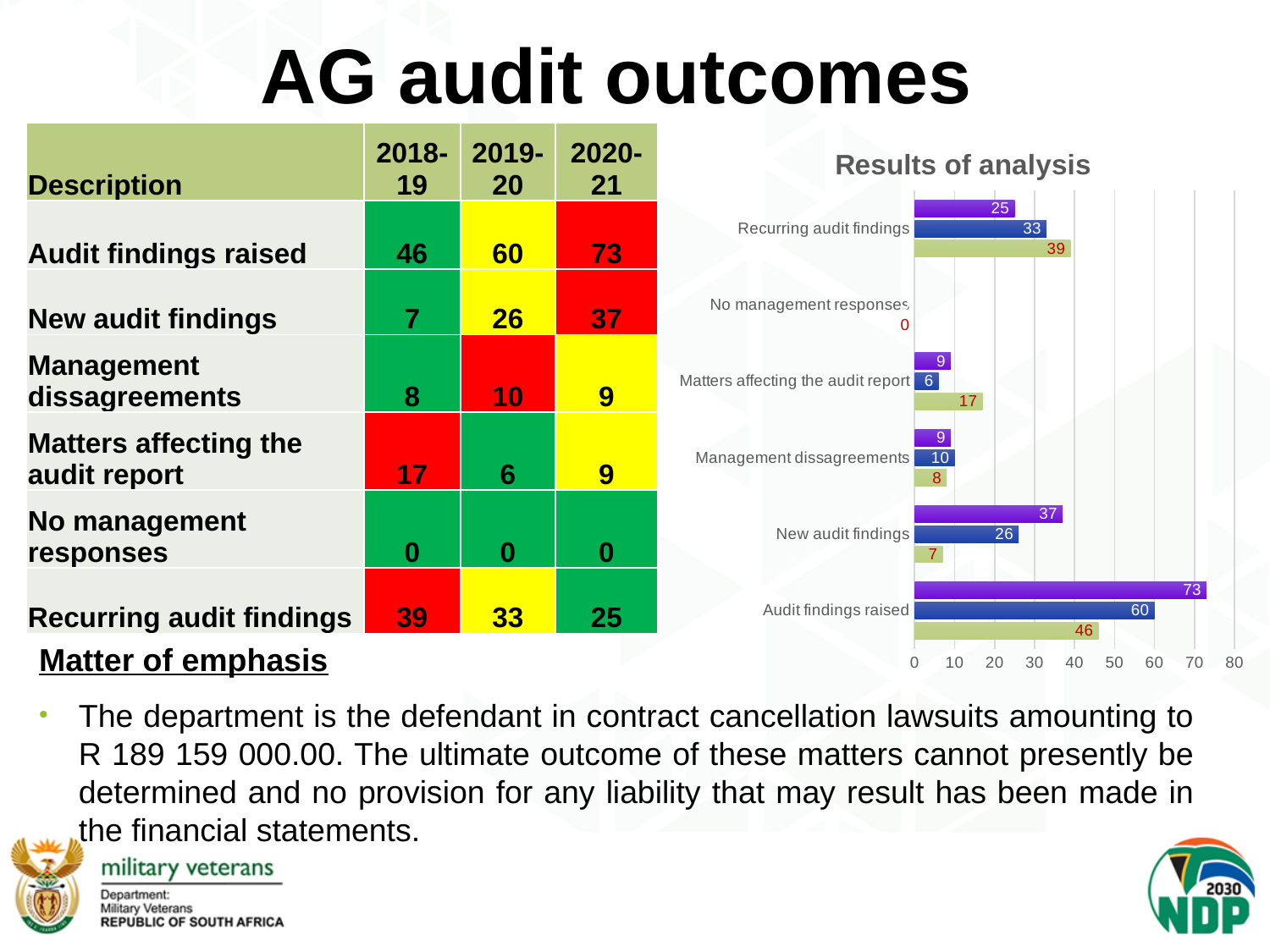
What is the title of the chart on the slide? Results of analysis How many categories are plotted on the "Results of analysis" chart? 6 In the "Results of analysis" chart, what is the value of the olive-green bar for Matters affecting the audit report? 17 In the "Results of analysis" chart, what is the difference between the olive-green bar and the purple bar for Recurring audit findings? 14 In the "Results of analysis" chart, which is larger for Management dissagreements: the blue bar or the olive-green bar? the blue bar In the "Results of analysis" chart, which category has the highest value across all bars? Audit findings raised What type of chart is shown under the title "Results of analysis"? bar chart In the "Results of analysis" chart, what is the value of the blue bar for New audit findings? 26 In the "Results of analysis" chart, is the purple bar for Audit findings raised greater or less than 70? greater In the "Results of analysis" chart, what is the value of the purple bar for Audit findings raised? 73 In the "Results of analysis" chart, what is the difference between the purple bar and the olive-green bar for Audit findings raised? 27 In the "Results of analysis" chart, which category has a value of 0 for every bar? No management responses